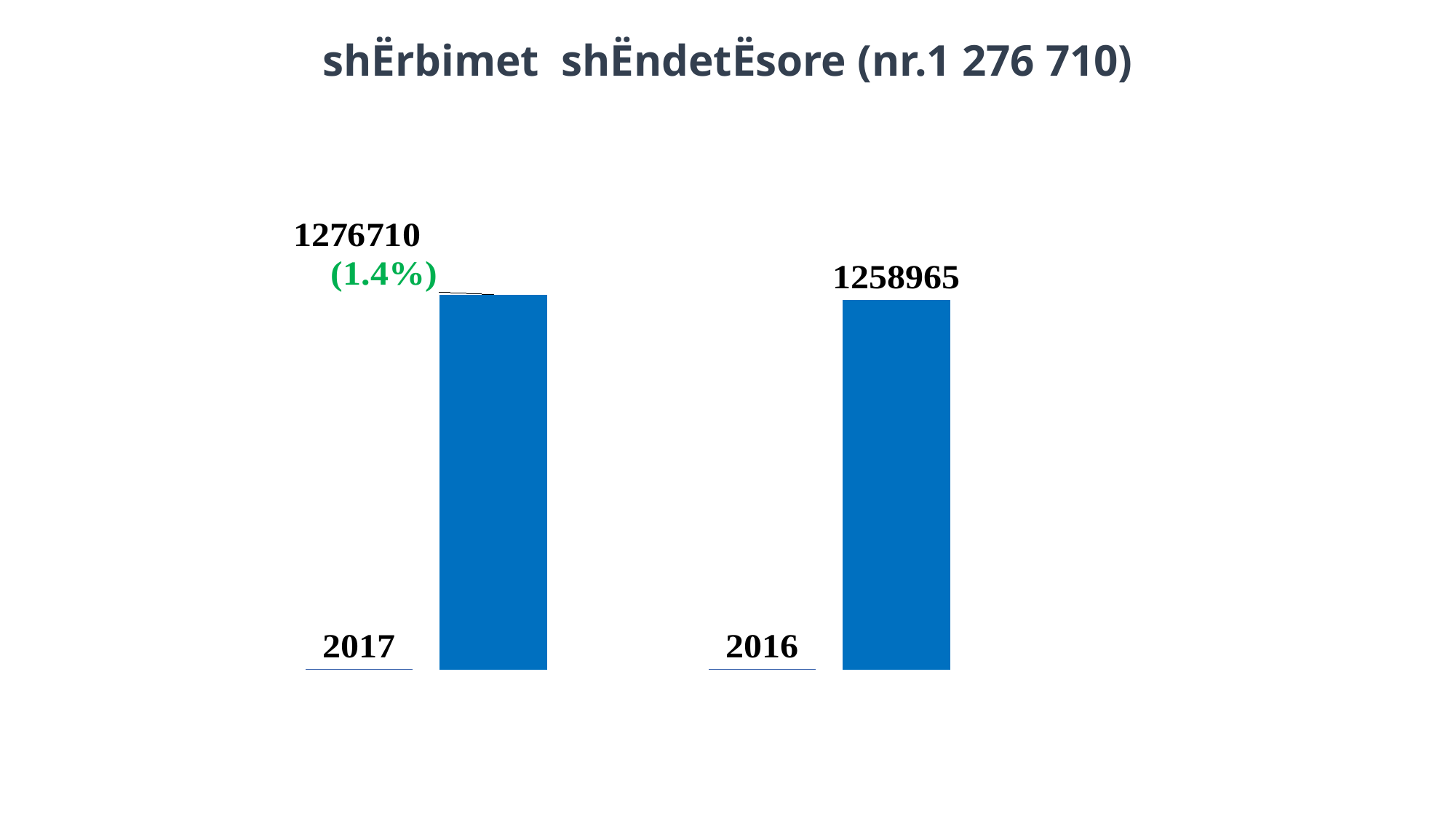
What is the difference between the 2017 value and the 2016 value? 17745 How many bars are shown in the chart? 2 Which year has the lower value? 2016 Is the value for 2017 larger or smaller than the value for 2016? larger Is the value for 2016 greater or less than 1276710? less What is the value for 2016? 1258965 Which year has the higher value? 2017 What number is given in parentheses in the chart title? nr.1 276 710 What percentage change is shown in green next to the 2017 bar? (1.4%) What kind of chart is shown on the slide? bar chart What is the value for 2017? 1276710